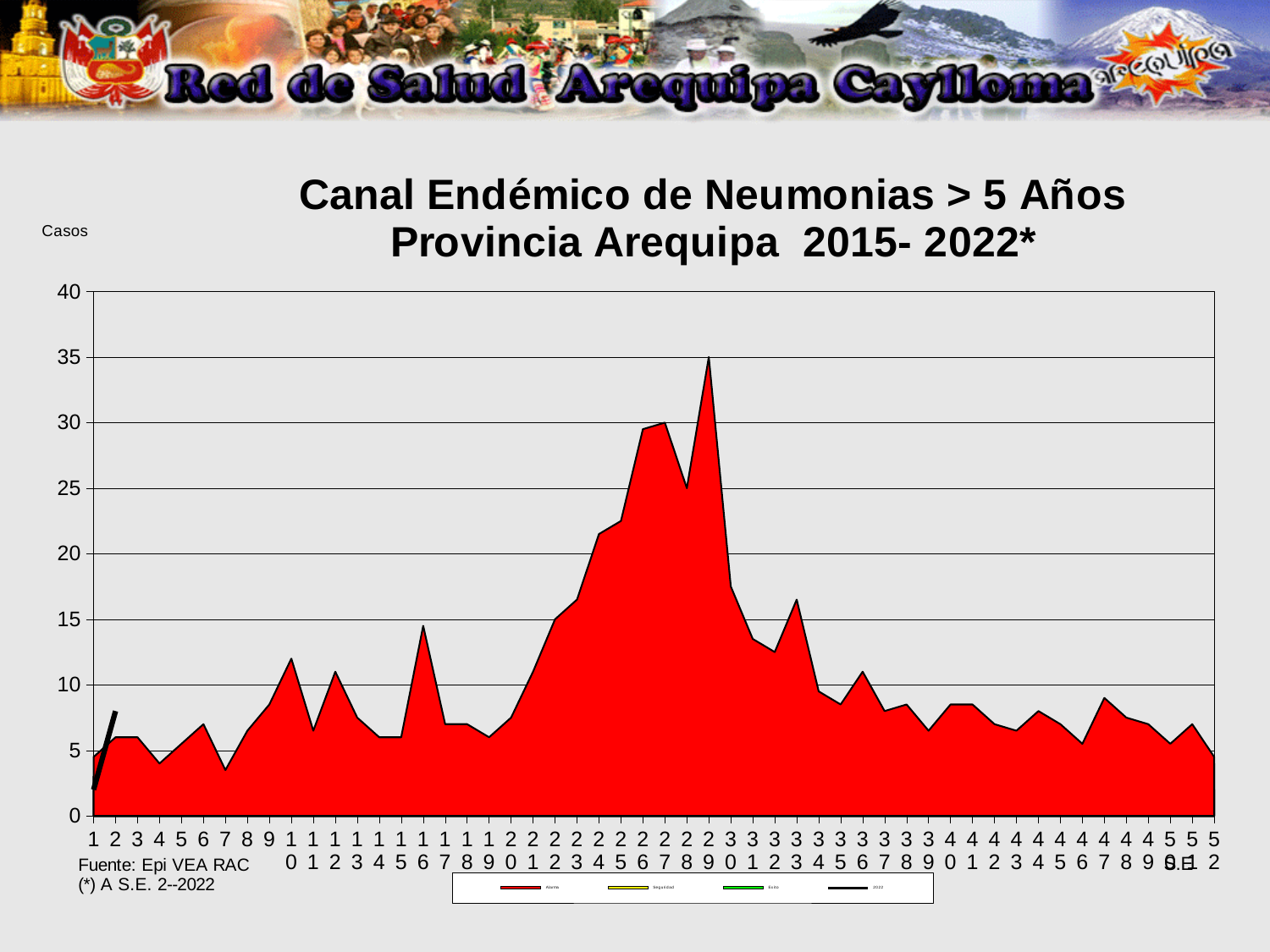
Is the value of the red area at week 33 greater or less than 15? greater Which is larger, the value of the red area at week 29 or at week 52? Week 29 Which legend entry corresponds to the red filled area? Alarma Do the values of the red area rise or fall from week 29 to week 35? Fall How many epidemiological weeks are shown along the x axis? 52 Is the value of the red area at week 10 greater or less than 10? greater What is the title of the chart? Canal Endémico de Neumonias > 5 Años Provincia Arequipa 2015- 2022* What kind of chart is shown on the slide? Area chart Is the value of the red area at week 1 greater or less than 5? less At which week does the red area reach its highest value? 29 How many series does the chart legend list? 4